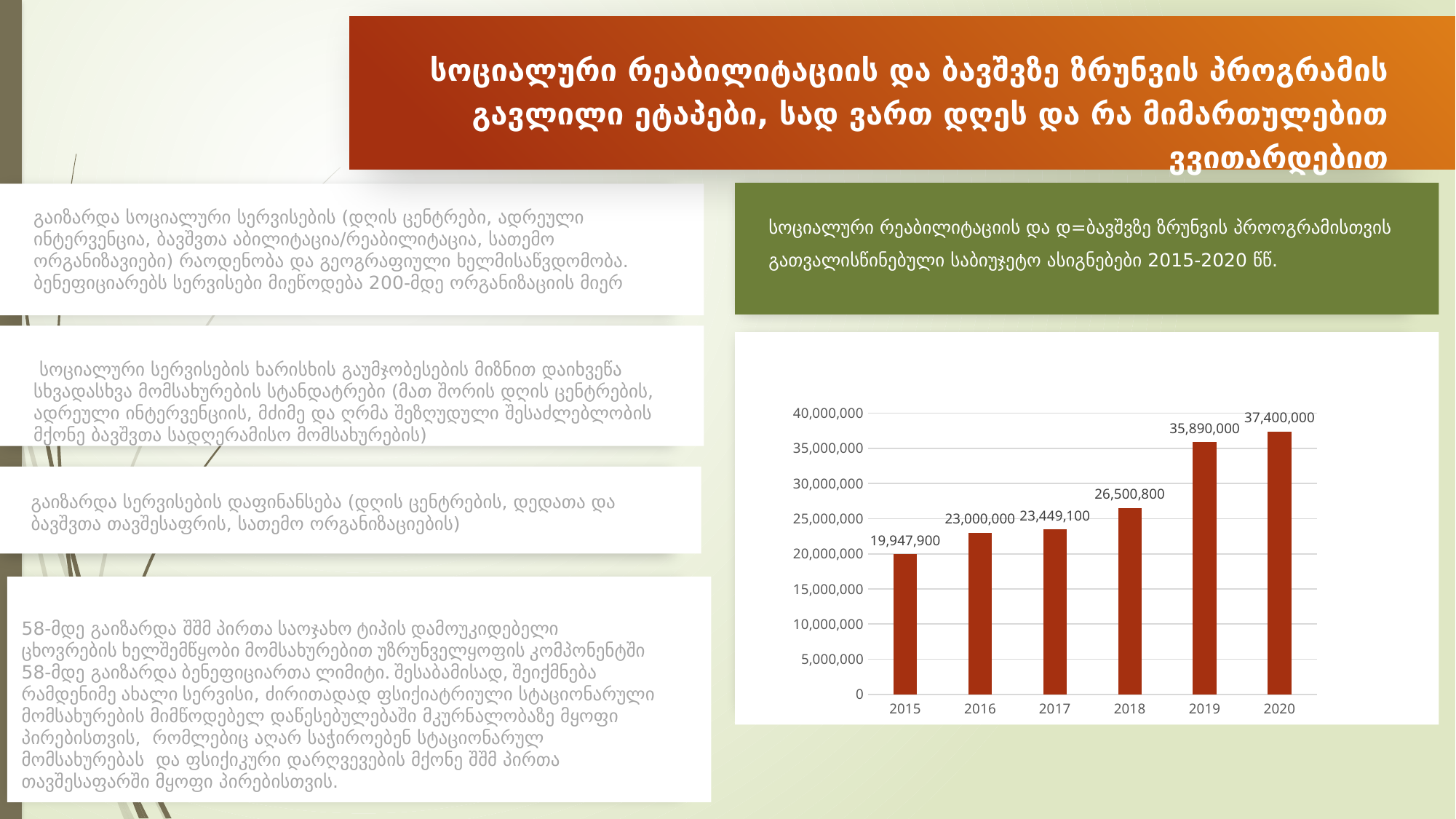
Which is larger, the value for 2016 or the value for 2018? 2018 Which year has the highest value? 2020 What is the value for 2018? 26,500,800 What kind of chart is shown? bar chart How many years are shown on the x axis? 6 What is the difference between the values for 2020 and 2019? 1,510,000 Which year has the lowest value? 2015 What is the value for 2020? 37,400,000 What is the value for 2015? 19,947,900 Do the values rise or fall from 2015 to 2020? rise What is the difference between the values for 2019 and 2018? 9,389,200 Is the value for 2019 greater or less than 30,000,000? greater